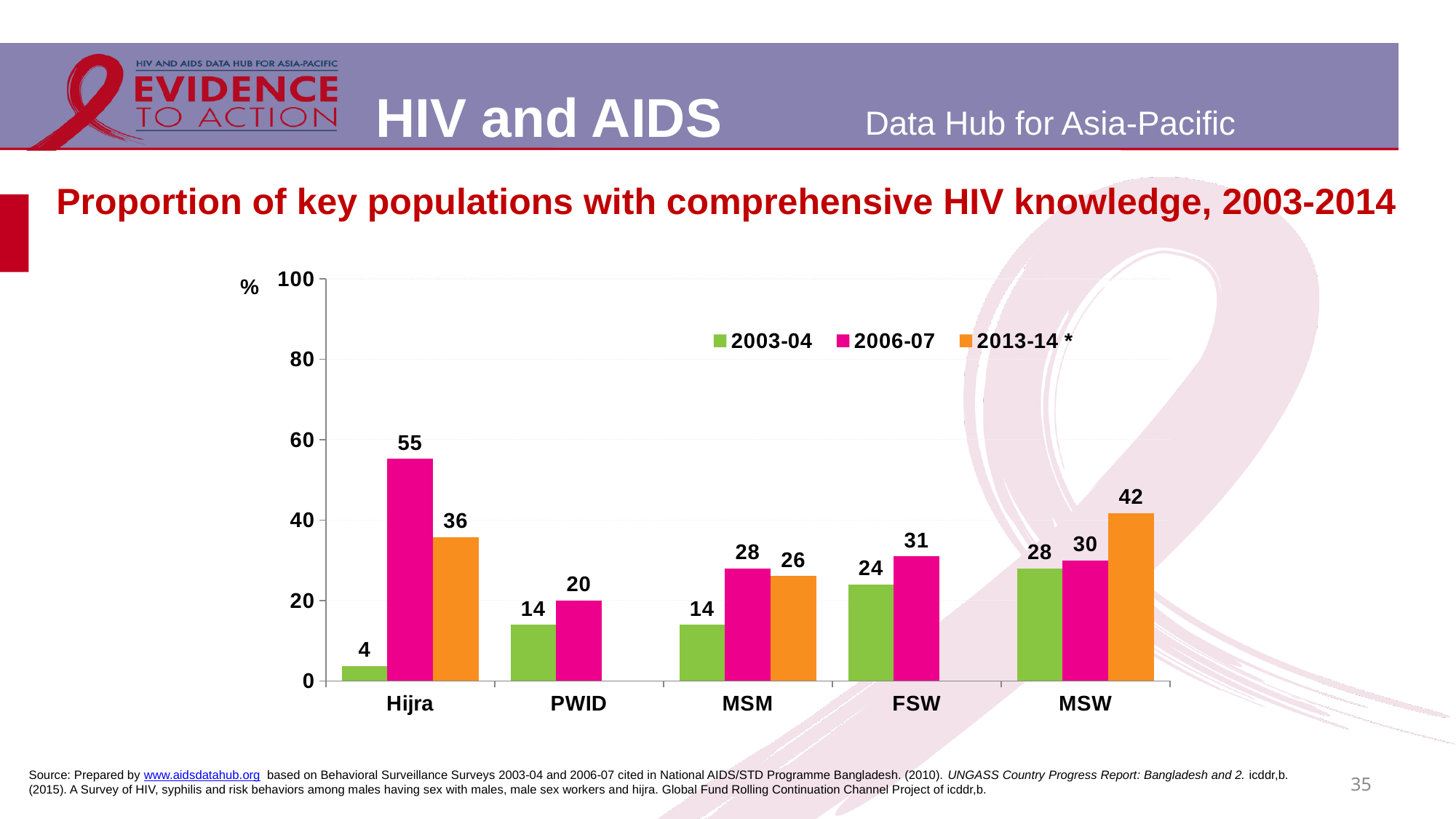
What is the value for MSW in the 2013-14 * series? 42 What is the value for Hijra in the 2006-07 series? 55 How many categories are shown on the x axis? 5 Which category has no bar for the 2013-14 * series? PWID and FSW Which category has the lowest value in the 2003-04 series? Hijra Which is larger for MSM: the 2006-07 value or the 2013-14 * value? 2006-07 What is the value for FSW in the 2003-04 series? 24 What is the difference between the 2003-04 and 2006-07 values for PWID? 6 What is the difference between the 2006-07 and 2013-14 * values for Hijra? 19 What kind of chart is shown on the slide? Bar chart Which category has the highest value in the 2006-07 series? Hijra How many series does the legend list? 3